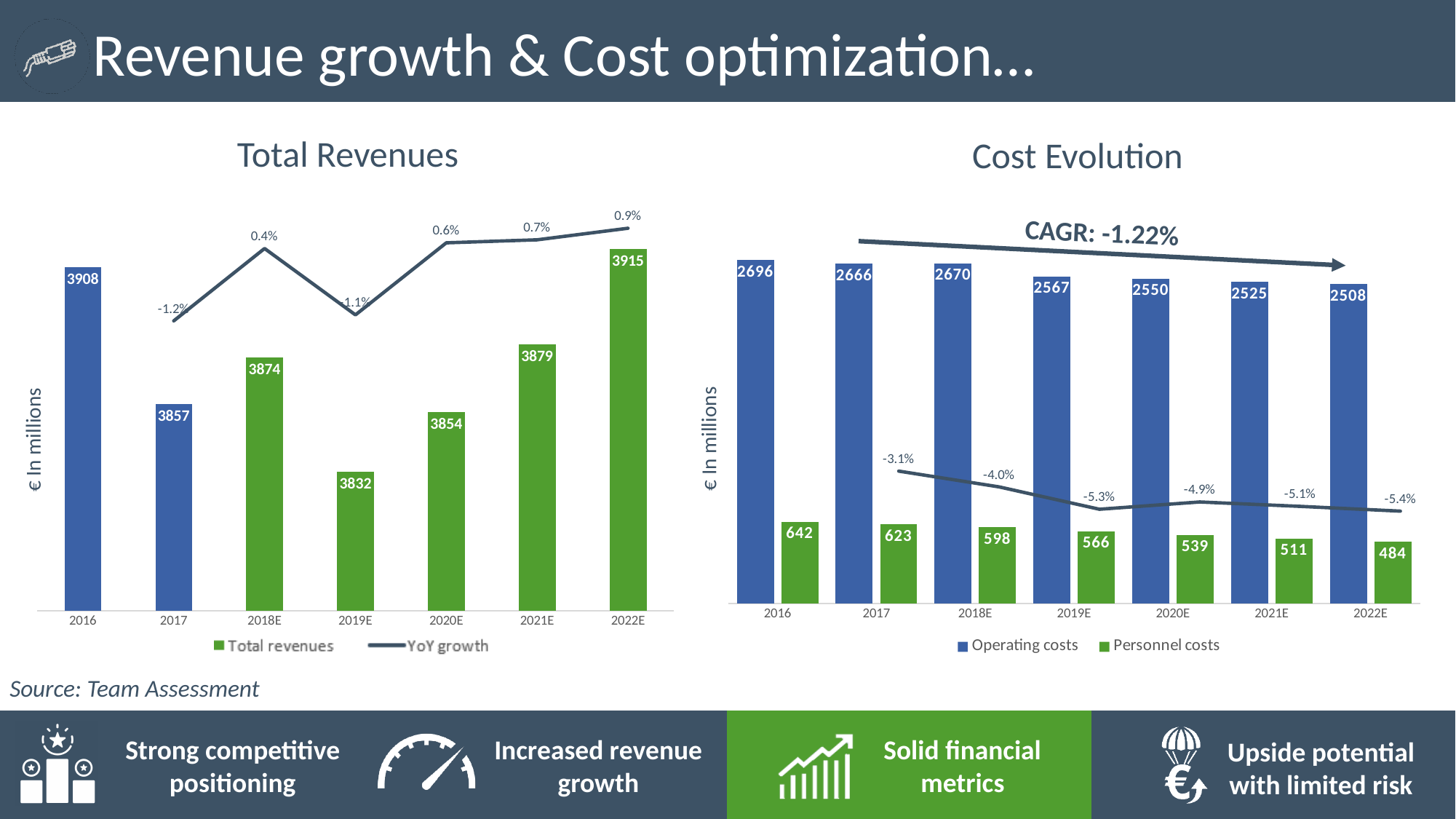
In the Total Revenues chart, which year has the lowest total revenue? 2019E In the Total Revenues chart, what is the YoY growth value shown for 2022E? 0.9% In the Cost Evolution chart, do personnel costs rise or fall from 2016 to 2022E? fall In the Cost Evolution chart, what is the operating costs value for 2019E? 2567 In the Cost Evolution chart, which year has the highest operating costs? 2016 In the Total Revenues chart, how many series does the legend list? 2 In the Total Revenues chart, what is the total revenue value for 2016? 3908 In the Cost Evolution chart, how many years are shown on the x axis? 7 What CAGR value is annotated on the Cost Evolution chart? -1.22% In the Cost Evolution chart, what is the personnel costs value for 2022E? 484 In the Total Revenues chart, what is the difference between the total revenues for 2022E and 2019E? 83 In the Cost Evolution chart, what is the difference between personnel costs in 2016 and 2022E? 158